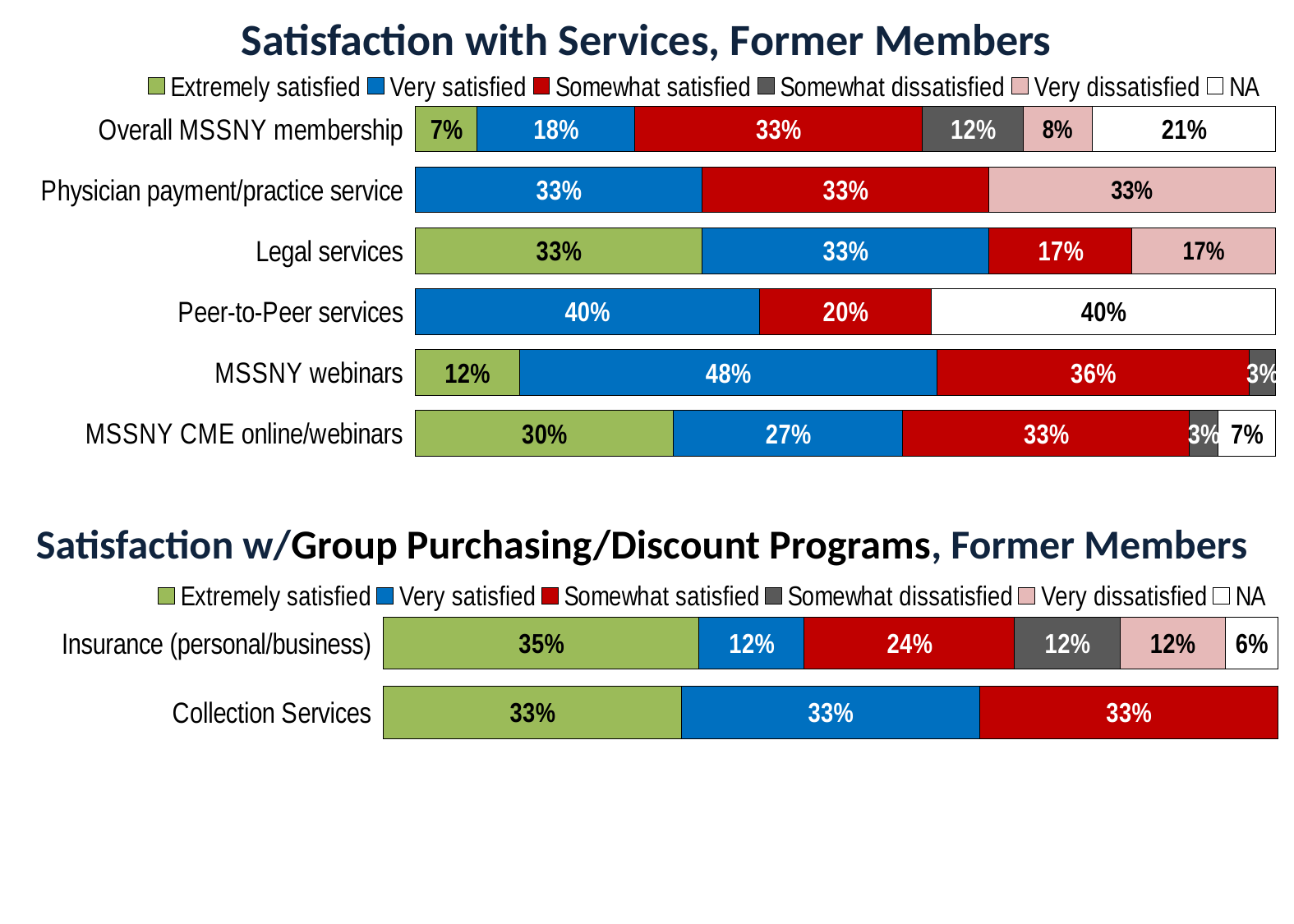
What kind of chart is the 'Satisfaction w/Group Purchasing/Discount Programs, Former Members' chart? Stacked bar chart How many series does the legend of the 'Satisfaction with Services, Former Members' chart list? 6 How many categories are shown in the 'Satisfaction w/Group Purchasing/Discount Programs, Former Members' chart? 2 In the 'Satisfaction w/Group Purchasing/Discount Programs, Former Members' chart, what is the Somewhat satisfied value for Insurance (personal/business)? 24% In the 'Satisfaction with Services, Former Members' chart, what is the Extremely satisfied value for MSSNY CME online/webinars? 30% In the 'Satisfaction w/Group Purchasing/Discount Programs, Former Members' chart, what is the difference between the Extremely satisfied and Very satisfied values for Insurance (personal/business)? 23% In the 'Satisfaction with Services, Former Members' chart, what is the NA value for Overall MSSNY membership? 21% In the 'Satisfaction with Services, Former Members' chart, what is the Very satisfied value for MSSNY webinars? 48% In the 'Satisfaction with Services, Former Members' chart, which category has the highest Very satisfied value? MSSNY webinars In the 'Satisfaction with Services, Former Members' chart, what is the difference between the Very satisfied and Somewhat satisfied values for Peer-to-Peer services? 20% How many categories are shown in the 'Satisfaction with Services, Former Members' chart? 6 In the 'Satisfaction with Services, Former Members' chart, which is larger for Legal services: Extremely satisfied or Somewhat satisfied? Extremely satisfied